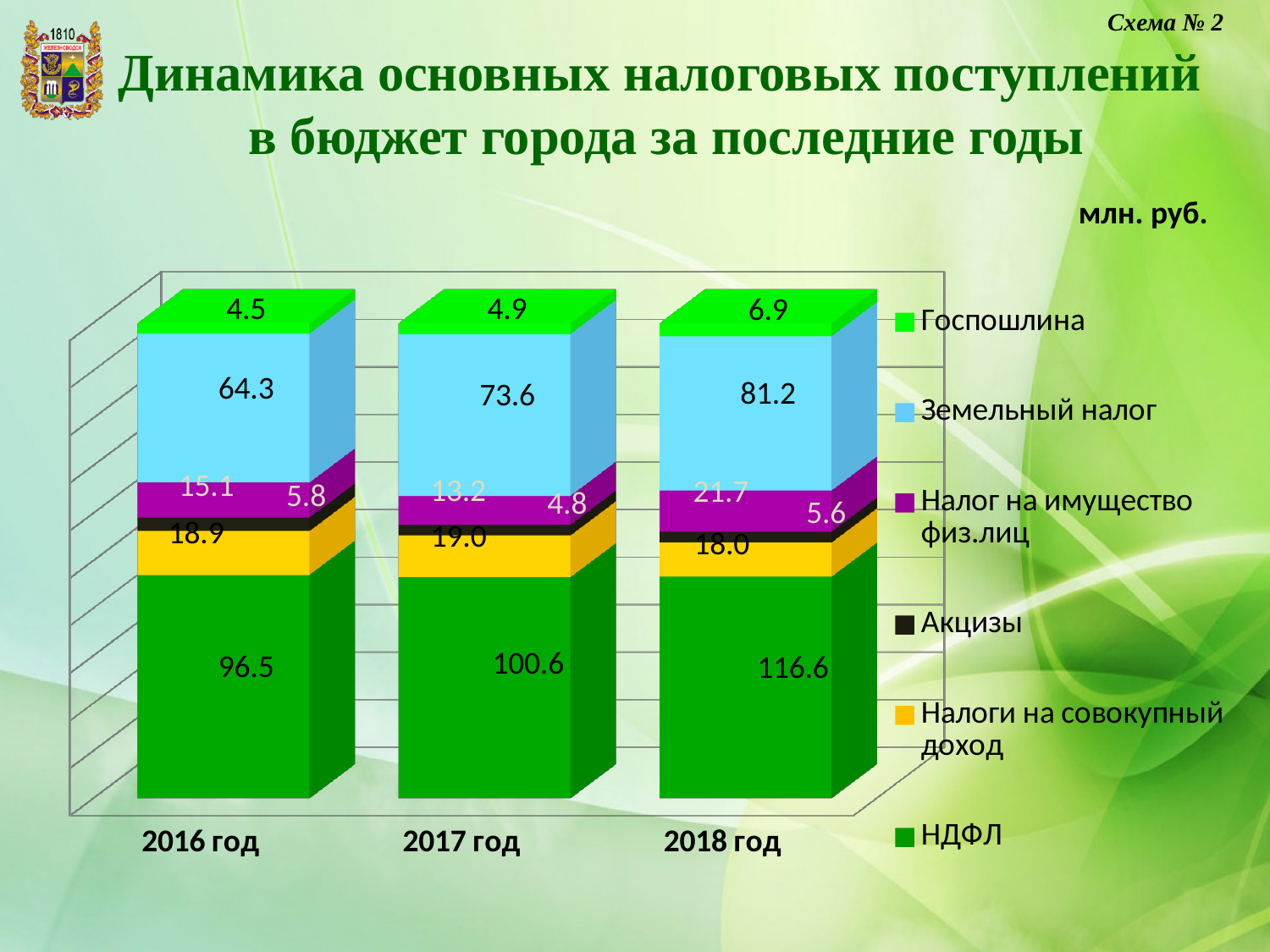
What is the value of Земельный налог for 2017 год? 73.6 How many years (categories) are shown on the x axis? 3 What is the difference between Земельный налог in 2018 год and 2016 год? 16.9 Which is larger: Налог на имущество физ.лиц in 2018 год or in 2017 год? 2018 год Does the value of НДФЛ rise or fall from 2016 год to 2018 год? rise In which year is Акцизы the lowest? 2017 год What is the value of Госпошлина for 2016 год? 4.5 In which year is НДФЛ the highest? 2018 год What type of chart is shown on the slide? stacked bar chart How many series does the legend list? 6 What is the total of the stacked bar for 2018 год? 250.0 What is the value of НДФЛ for 2018 год? 116.6